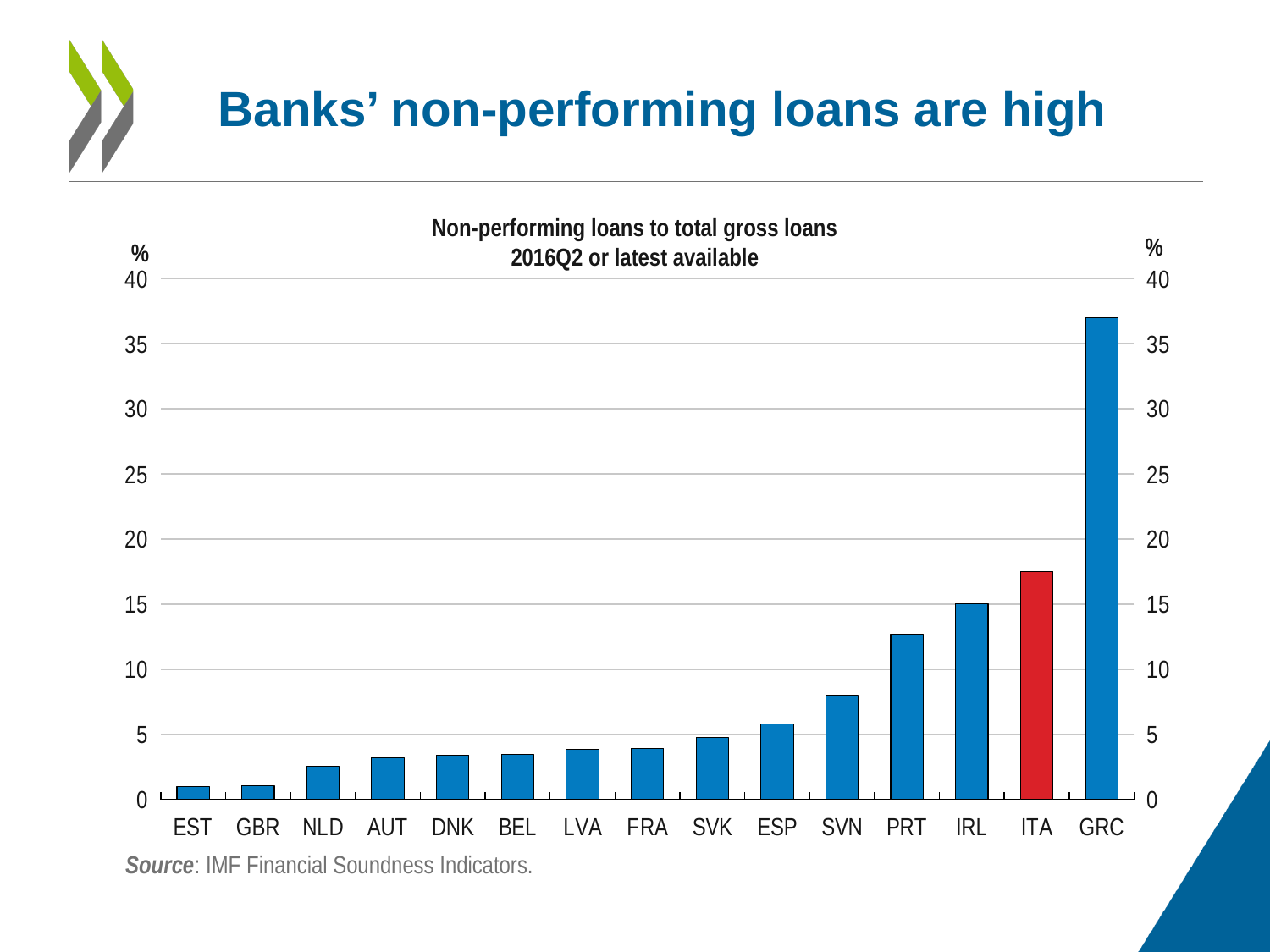
Is the value for SVN greater or less than 5? greater Is the value for PRT greater or less than 10? greater Is the value for ITA greater or less than 15? greater Which has a higher share of non-performing loans, ITA or IRL? ITA Which country has the highest share of non-performing loans to total gross loans? GRC Which has a lower share of non-performing loans, NLD or SVK? NLD Which country's bar is coloured red rather than blue? ITA How many countries are shown on the x axis of the chart? 15 Do the values rise or fall moving from left to right along the x axis? rise What kind of chart is shown on the slide? bar chart